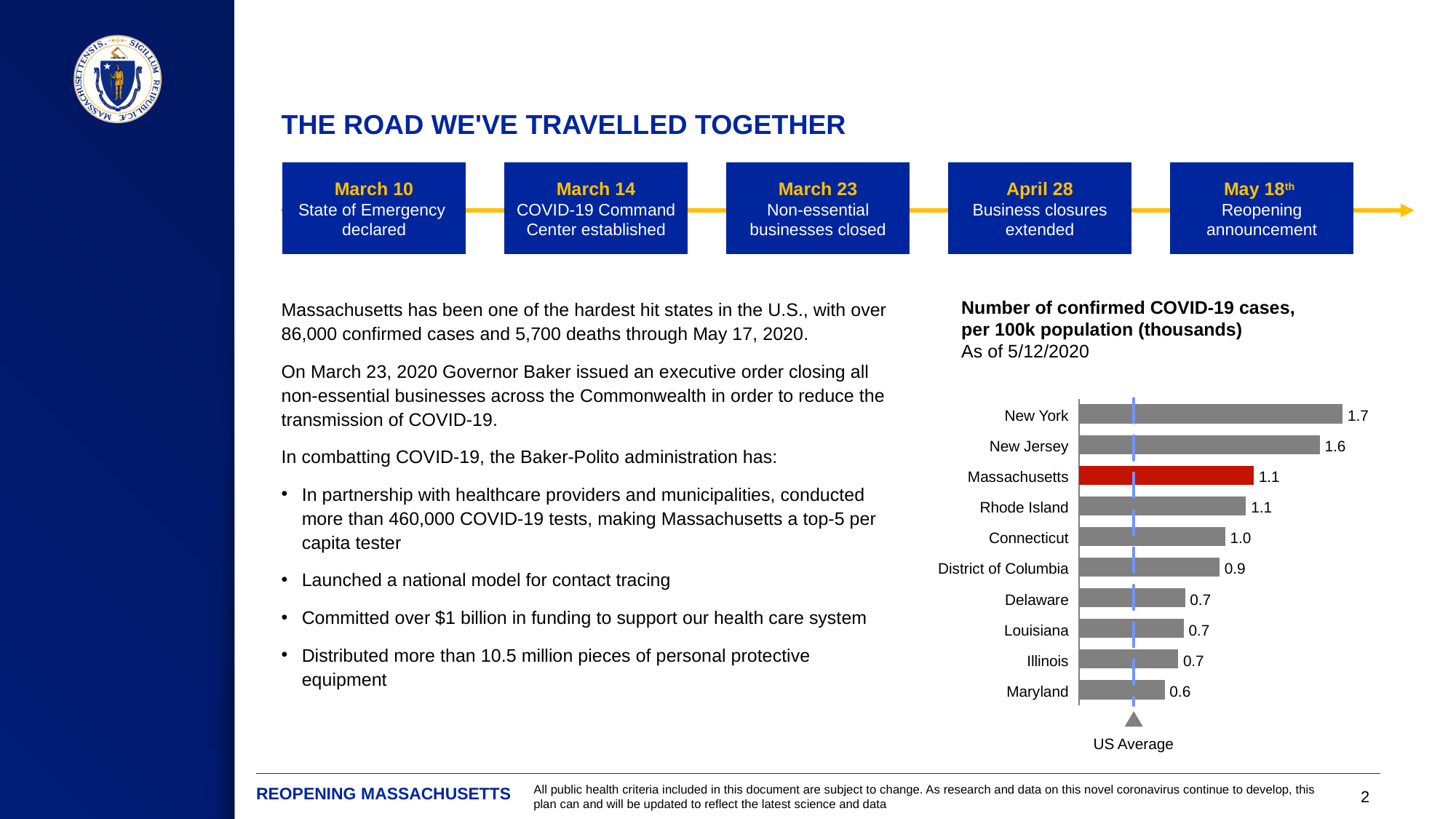
Which state has the highest number of confirmed COVID-19 cases per 100k population in the chart? New York How many states or districts are shown in the chart? 10 What is the value for District of Columbia in the chart? 0.9 What is the value for Massachusetts in the chart? 1.1 What is the difference between the values for New York and Maryland? 1.2 What type of chart is used to show confirmed COVID-19 cases per 100k population? Bar chart What is the difference between the values for New Jersey and Connecticut? 0.6 Which category has the lowest value in the chart? Maryland Which bar in the chart is highlighted in red? Massachusetts What is the value for New York in the chart of confirmed COVID-19 cases per 100k population? 1.7 Which has a larger value, New Jersey or Connecticut? New Jersey What is the value for Maryland in the chart? 0.6